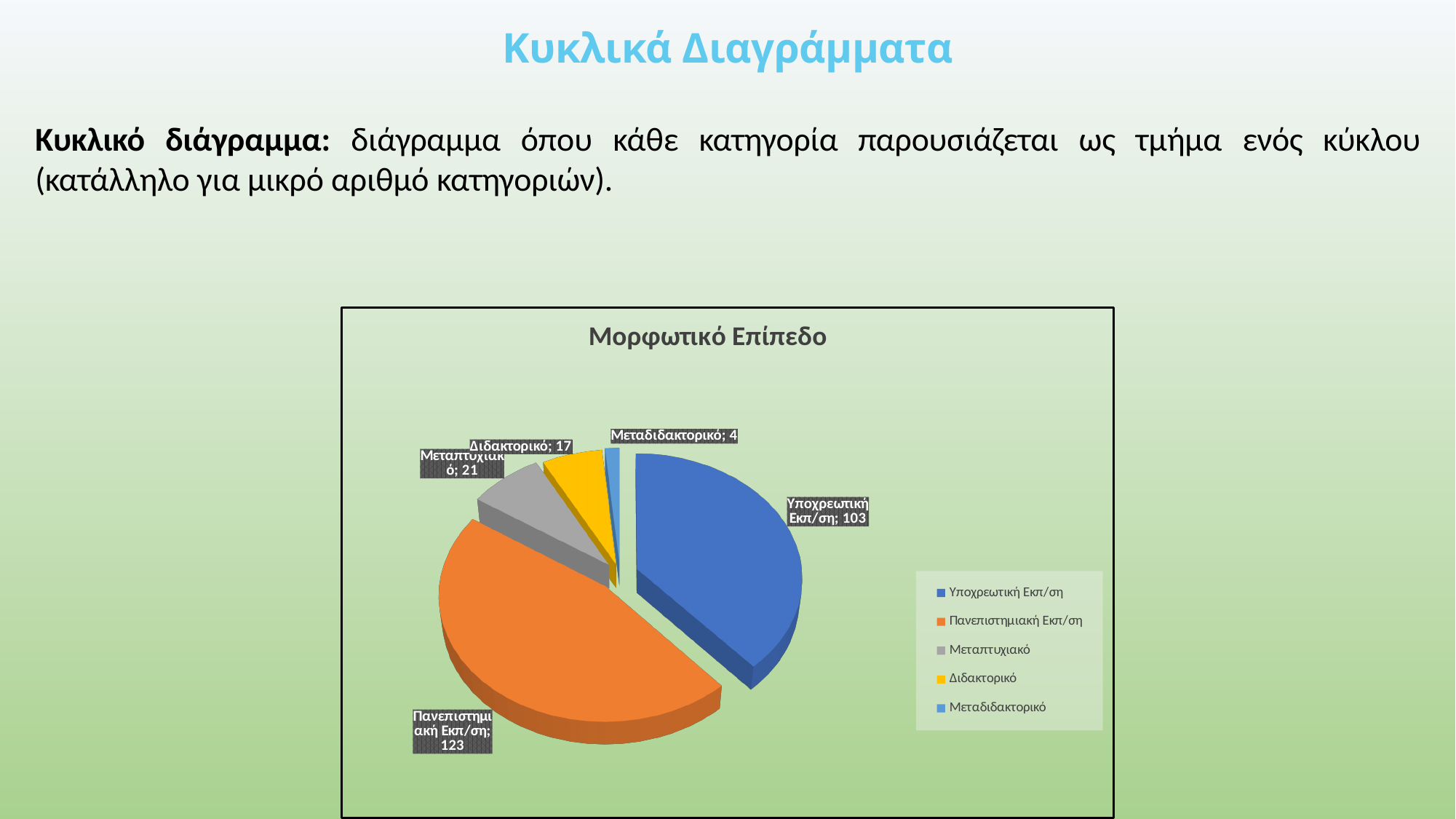
What is the value for Διδακτορικό? 17 What is the value for Υποχρεωτική Εκπ/ση? 103 What is the value for Πανεπιστημιακή Εκπ/ση? 123 What is the value for Μεταδιδακτορικό? 4 What type of chart is shown on the slide? Pie chart What is the title of the chart? Μορφωτικό Επίπεδο Which category has the smallest slice? Μεταδιδακτορικό Which is larger, the value for Μεταπτυχιακό or the value for Διδακτορικό? Μεταπτυχιακό What is the difference between the values for Πανεπιστημιακή Εκπ/ση and Υποχρεωτική Εκπ/ση? 20 Which category has the largest slice? Πανεπιστημιακή Εκπ/ση How many categories does the legend list? 5 What is the value for Μεταπτυχιακό? 21